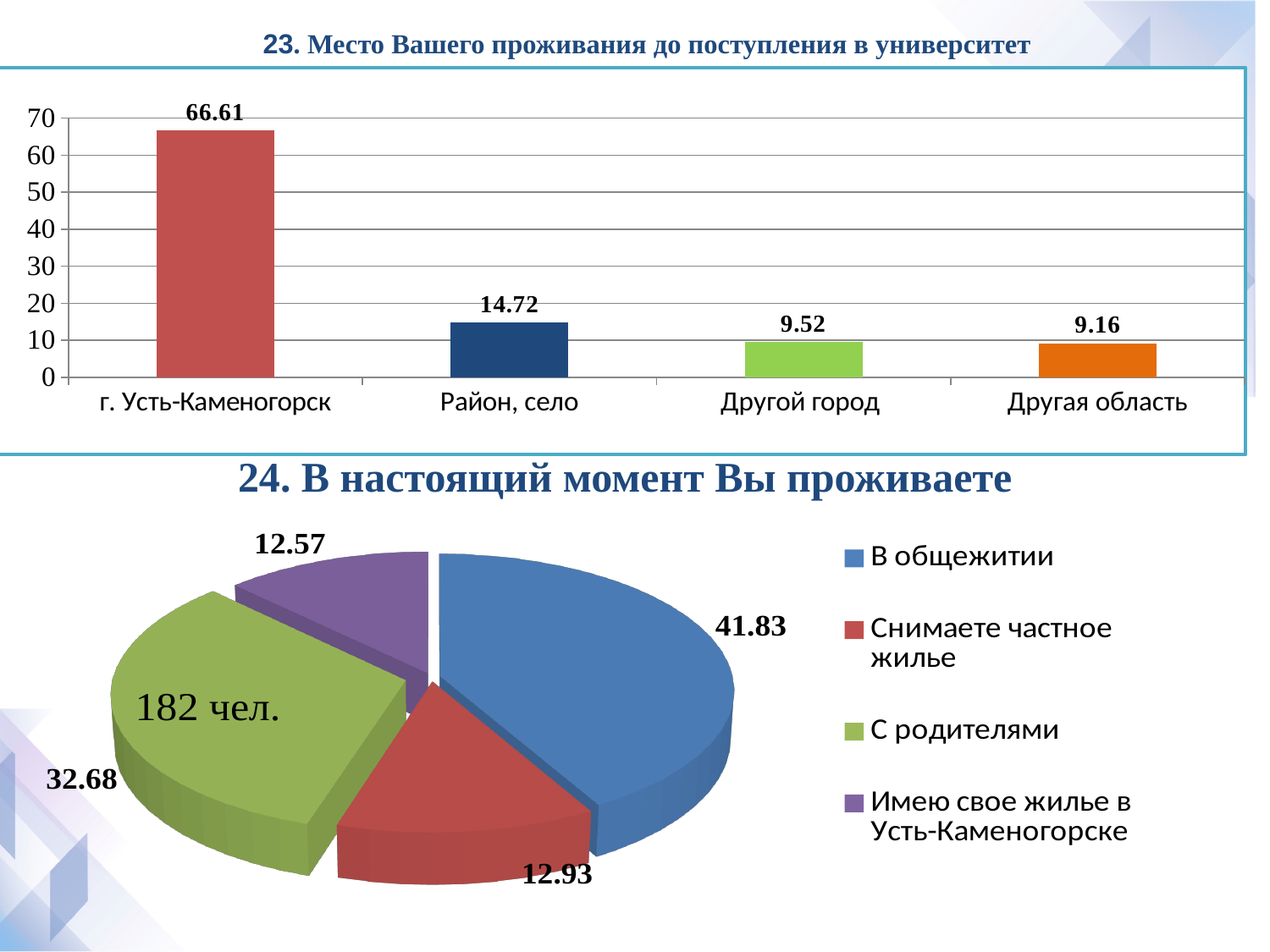
In the pie chart for question 24, how many entries does the legend list? 4 In the pie chart for question 24, what is the value for С родителями? 32.68 In the pie chart for question 24, what is the value for В общежитии? 41.83 In the bar chart for question 23, what is the difference between the values for Район, село and Другой город? 5.2 What kind of chart is shown at the top of the slide for question 23? bar chart In the bar chart for question 23, how many categories are shown on the x axis? 4 In the pie chart for question 24, which is larger: Снимаете частное жилье or Имею свое жилье в Усть-Каменогорске? Снимаете частное жилье In the bar chart for question 23, what is the value for Другая область? 9.16 In the bar chart for question 23, is the value for Район, село greater or less than 20? less In the bar chart for question 23, what is the value for г. Усть-Каменогорск? 66.61 In the bar chart for question 23, which category has the highest value? г. Усть-Каменогорск In the pie chart for question 24, what text is printed in the centre of the pie? 182 чел.